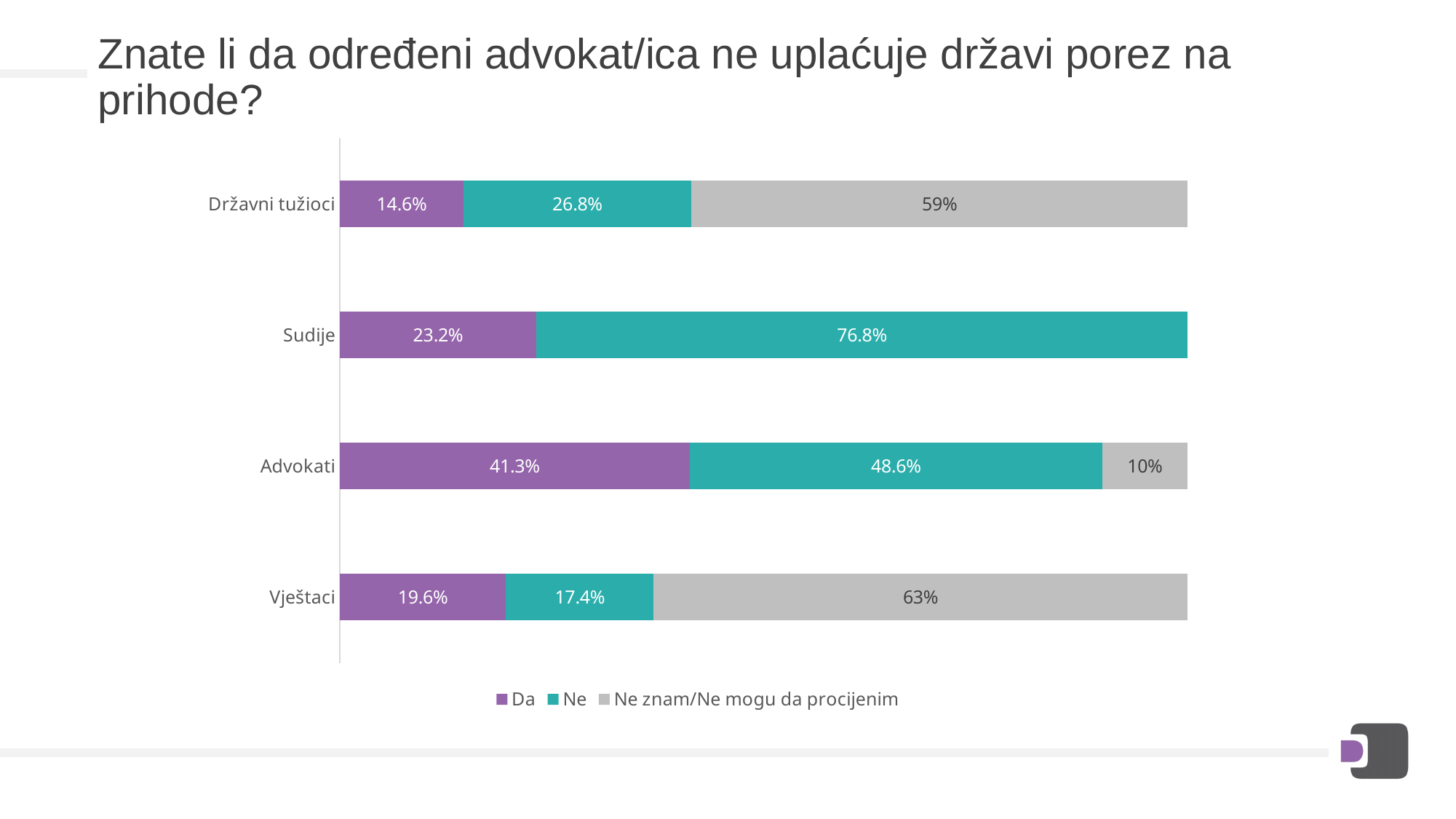
What is the 'Ne' value for Sudije? 76.8% How many series does the legend list? 3 How many categories are shown on the chart? 4 Which category has the highest 'Da' value? Advokati What is the 'Ne znam/Ne mogu da procijenim' value for Vještaci? 63% What is the difference between the 'Ne' values for Sudije and Advokati? 28.2% Which category has the lowest 'Da' value? Državni tužioci What is the 'Da' value for Advokati? 41.3% Which is larger, the 'Ne znam/Ne mogu da procijenim' value for Vještaci or for Državni tužioci? Vještaci What is the 'Ne' value for Državni tužioci? 26.8% What kind of chart is shown on the slide? Stacked bar chart Which series is shown in purple? Da